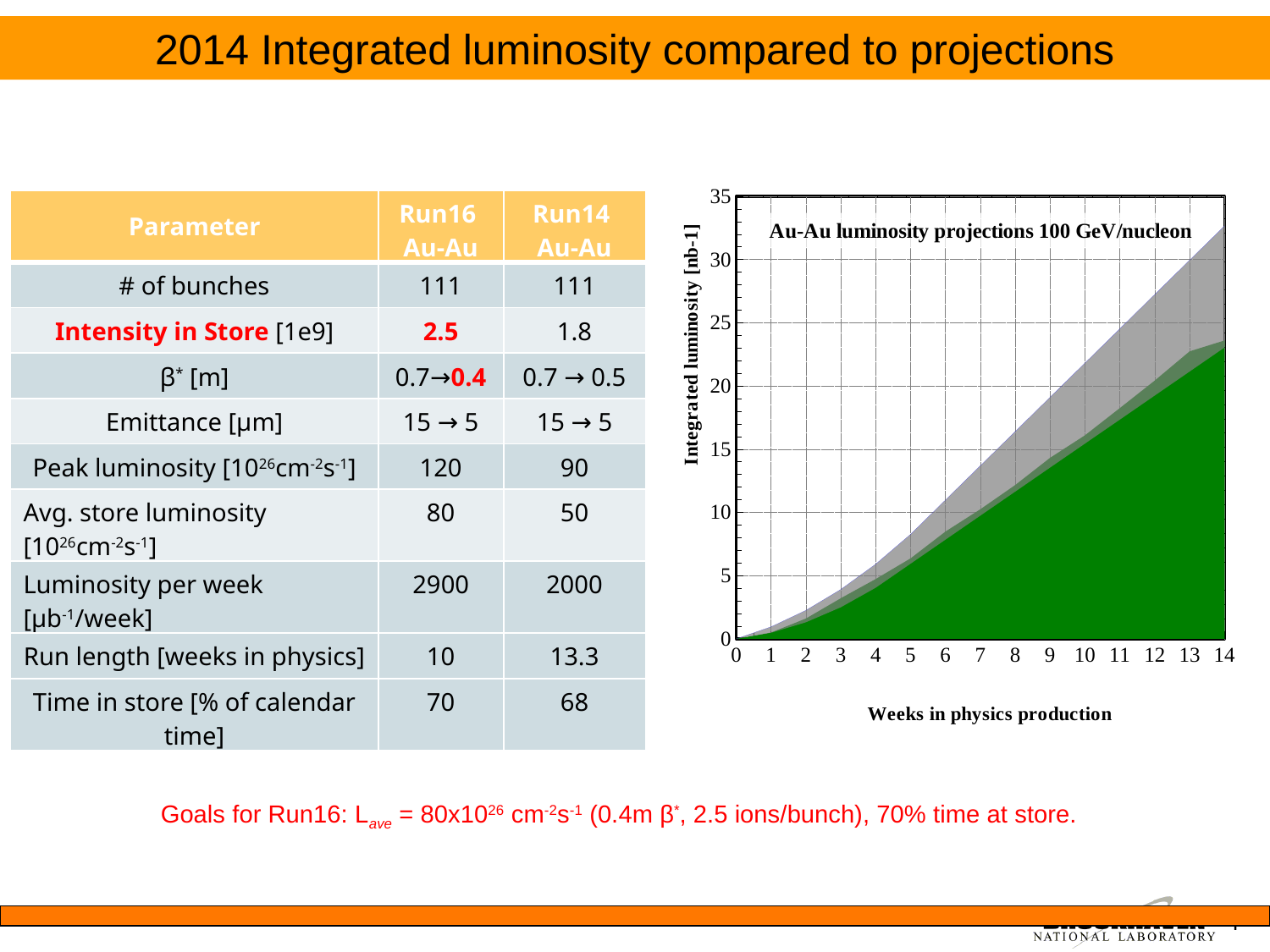
Is the top of the gray area at week 14 greater or less than 30? greater Is the top of the gray area at week 12 greater or less than 25? greater How many week tick marks are labelled on the x axis of the chart? 15 What kind of chart is shown on the right side of the slide? area chart What is the label of the x axis of the chart? Weeks in physics production Is the value of the green area at week 14 greater or less than 20? greater Do the integrated luminosity values rise or fall as the weeks in physics production increase? rise What is the title of the chart on the slide? Au-Au luminosity projections 100 GeV/nucleon What is the highest value shown on the y axis of the chart? 35